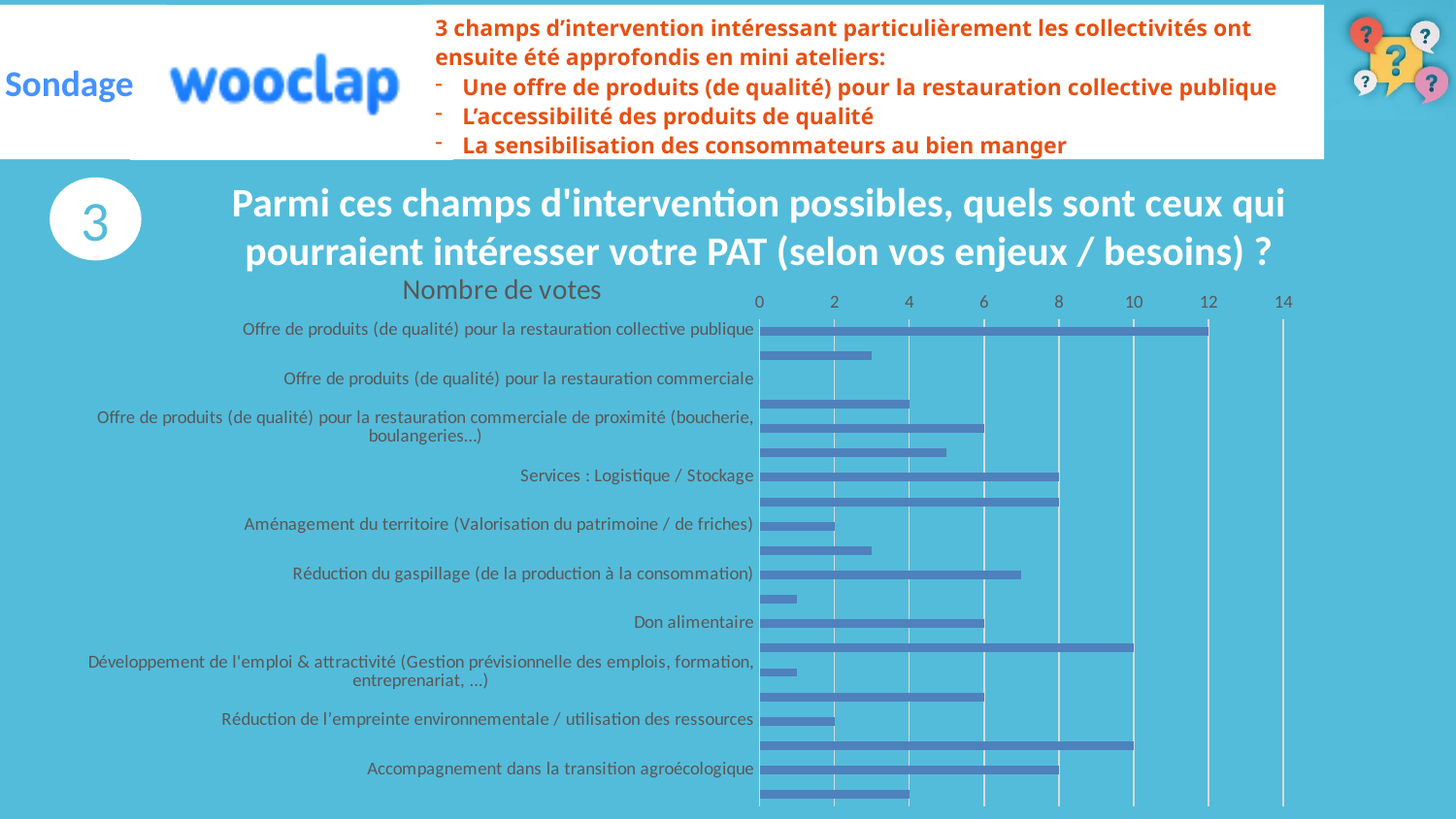
Is the value for 'Services : Logistique / Stockage' greater or less than 6? greater Which category received the highest number of votes? Offre de produits (de qualité) pour la restauration collective publique How many votes did 'Offre de produits (de qualité) pour la restauration collective publique' receive? 12 What is the title of the chart? Nombre de votes What type of chart is shown on the slide? bar chart What is the difference in votes between 'Offre de produits (de qualité) pour la restauration collective publique' and 'Services : Logistique / Stockage'? 4 How many votes did 'Services : Logistique / Stockage' receive? 8 What is the maximum value shown on the horizontal axis? 14 Which has more votes: 'Offre de produits (de qualité) pour la restauration collective publique' or 'Services : Logistique / Stockage'? Offre de produits (de qualité) pour la restauration collective publique How many category labels are readable on the vertical axis of the chart? 10 Is the value for 'Offre de produits (de qualité) pour la restauration collective publique' greater or less than 10? greater